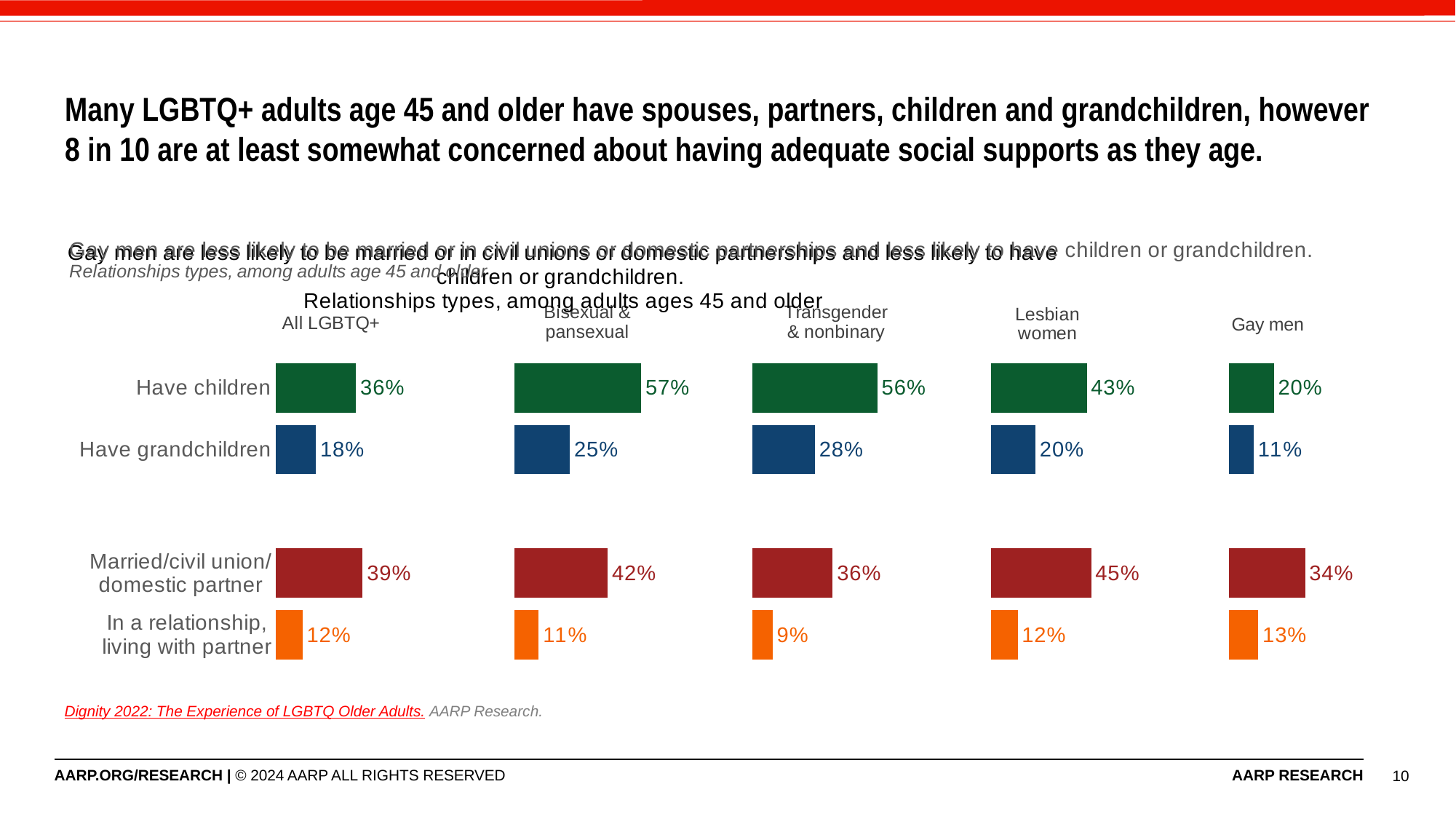
In the Gay men chart, what percentage have children? 20% How many groups (columns) are shown across the charts? 5 In the Transgender & nonbinary chart, what percentage have grandchildren? 28% Across the five group charts, which group has the highest percentage who have children? Bisexual & pansexual What kind of chart is used on this slide? Bar chart In the Lesbian women chart, what percentage are married/civil union/domestic partner? 45% In the Lesbian women chart, which is larger: the percentage who have children or the percentage who are married/civil union/domestic partner? Married/civil union/domestic partner In the All LGBTQ+ chart, what percentage are in a relationship, living with partner? 12% In the Bisexual & pansexual chart, what is the difference between the percentage who have children and the percentage who have grandchildren? 32 percentage points How many relationship-type categories are shown for each group? 4 Across the five group charts, which group has the lowest percentage who have grandchildren? Gay men What colour are the bars for 'Have grandchildren'? Dark blue